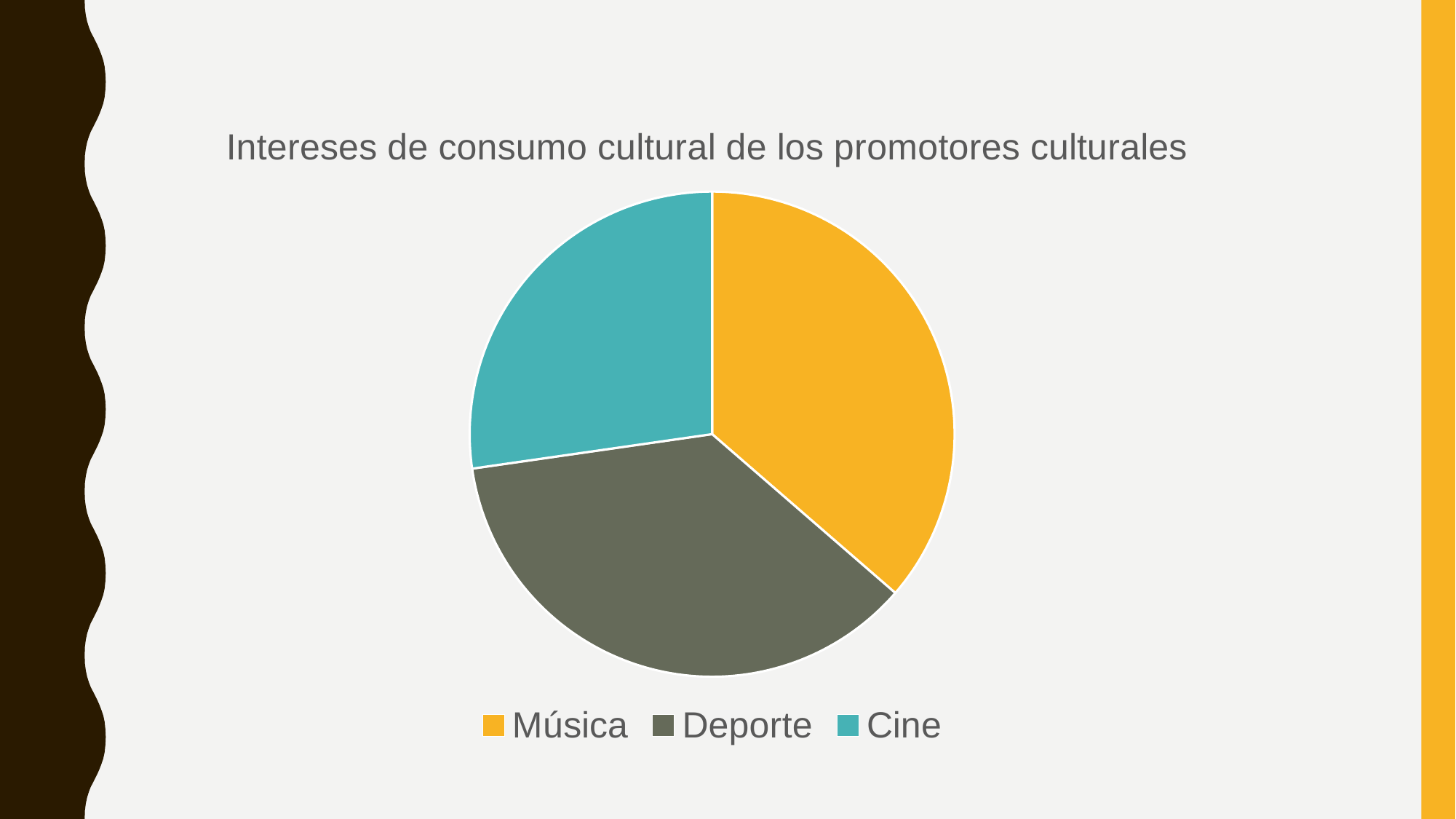
Which slice is larger, Deporte or Cine? Deporte What is the title of the chart? Intereses de consumo cultural de los promotores culturales How many slices does the pie chart have? 3 Which slice is larger, Música or Cine? Música Which category is shown in yellow in the pie chart? Música Which category has the smallest slice of the pie? Cine What kind of chart is shown on the slide? pie chart How many entries does the legend list? 3